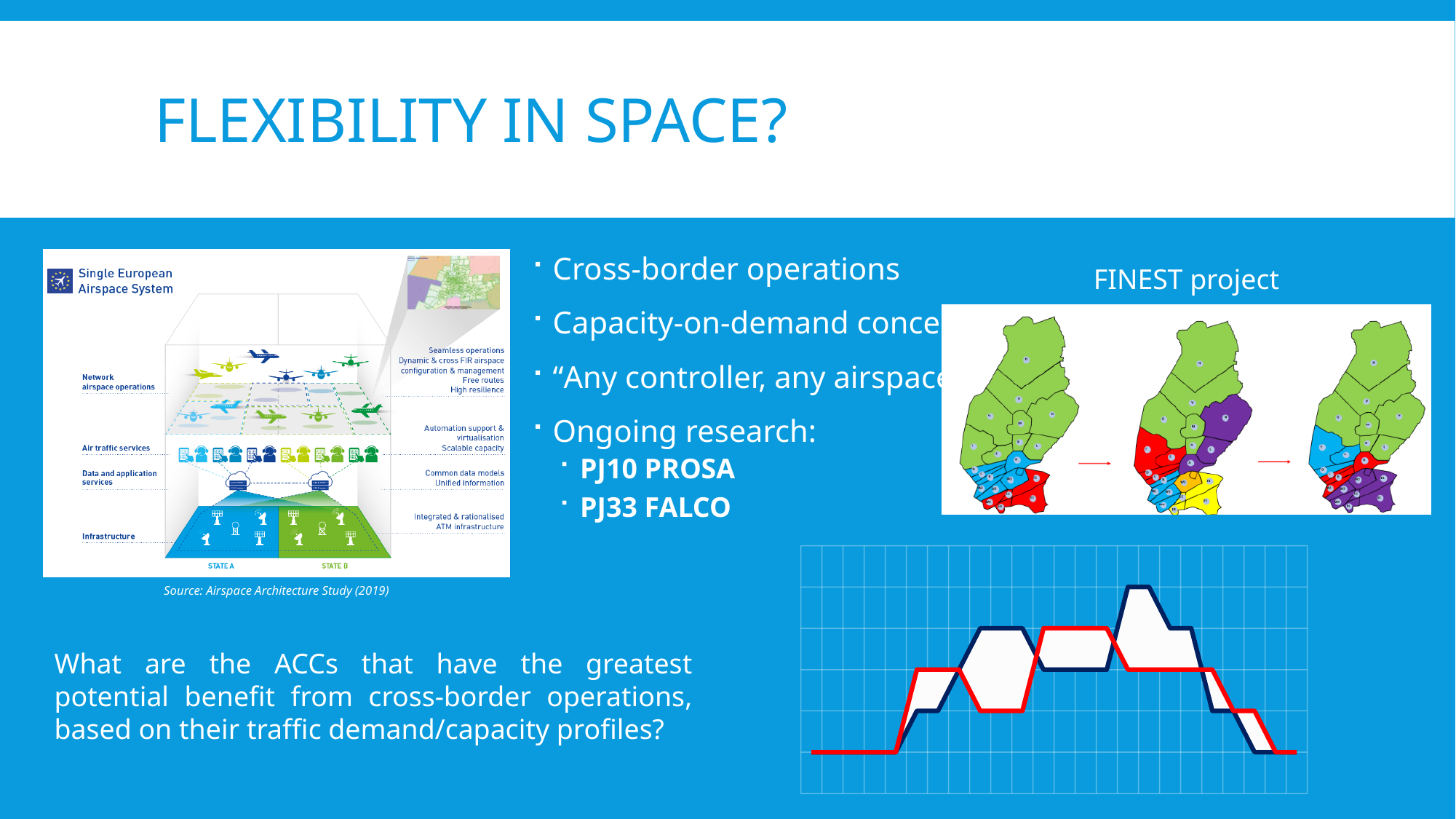
What colours are the two lines on the chart at the bottom right of the slide? red and dark blue What kind of chart is shown at the bottom right of the slide? line chart How many lines are plotted on the chart at the bottom right of the slide? 2 On the chart at the bottom right of the slide, do the lines rise or fall toward the right end of the x axis? fall